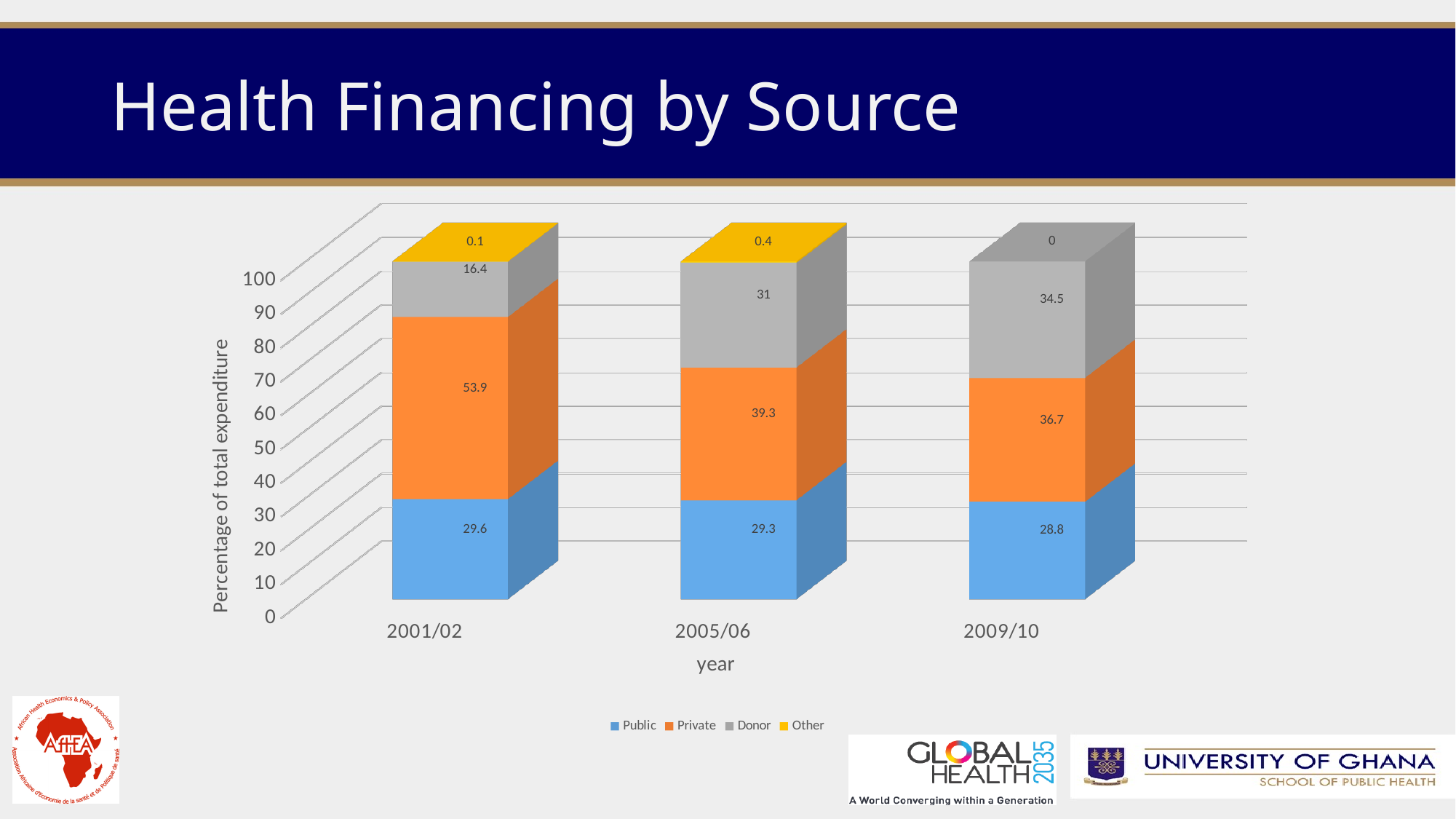
In which year is the Donor share highest? 2009/10 What is the Private value for 2001/02? 53.9 What is the Donor value for 2009/10? 34.5 What is the Other value for 2005/06? 0.4 In which year is the Private share lowest? 2009/10 How many years are shown on the x axis? 3 Which is larger for 2009/10, Private or Donor? Private What is the Public value for 2005/06? 29.3 How many series does the legend list? 4 Does the Public share rise or fall from 2001/02 to 2009/10? Fall What is the difference between the Private values for 2001/02 and 2005/06? 14.6 What kind of chart is shown? Stacked bar chart